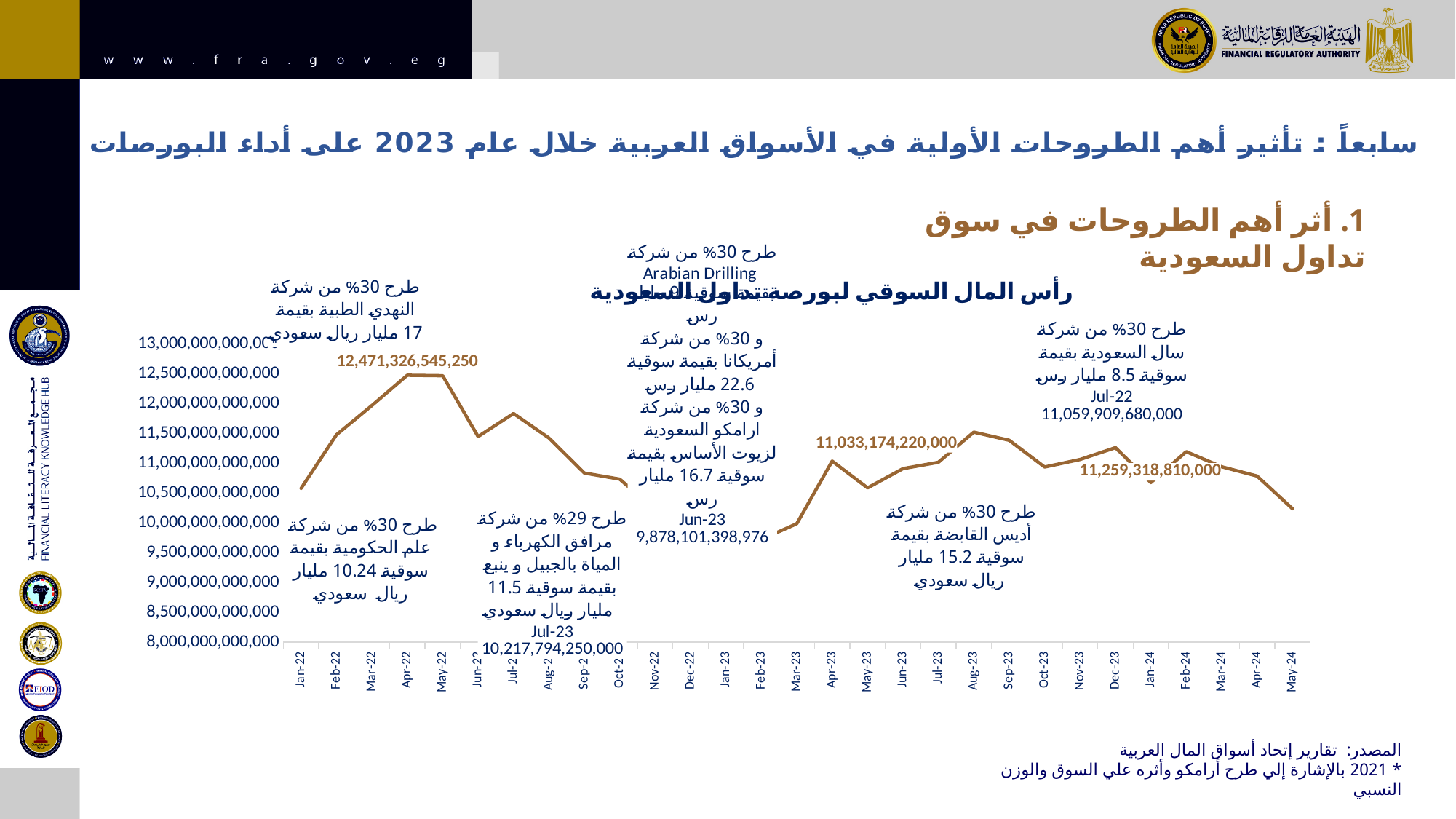
Is the value for Aug-23 greater or less than 11,000,000,000,000? greater Is the value for May-24 greater or less than 10,500,000,000,000? less Is the value for Jan-22 greater or less than 11,000,000,000,000? less Does the line rise or fall between May-22 and Oct-22? fall Which is larger, the value for Apr-22 or the value for May-24? Apr-22 What is the highest value labelled on the chart? 12,471,326,545,250 What is the last month shown on the x axis of the chart? May-24 What is the title of the chart? رأس المال السوقي لبورصة تداول السعودية What kind of chart is shown on the slide? line chart What is the first month shown on the x axis of the chart? Jan-22 How many monthly points are shown along the x axis of the chart? 29